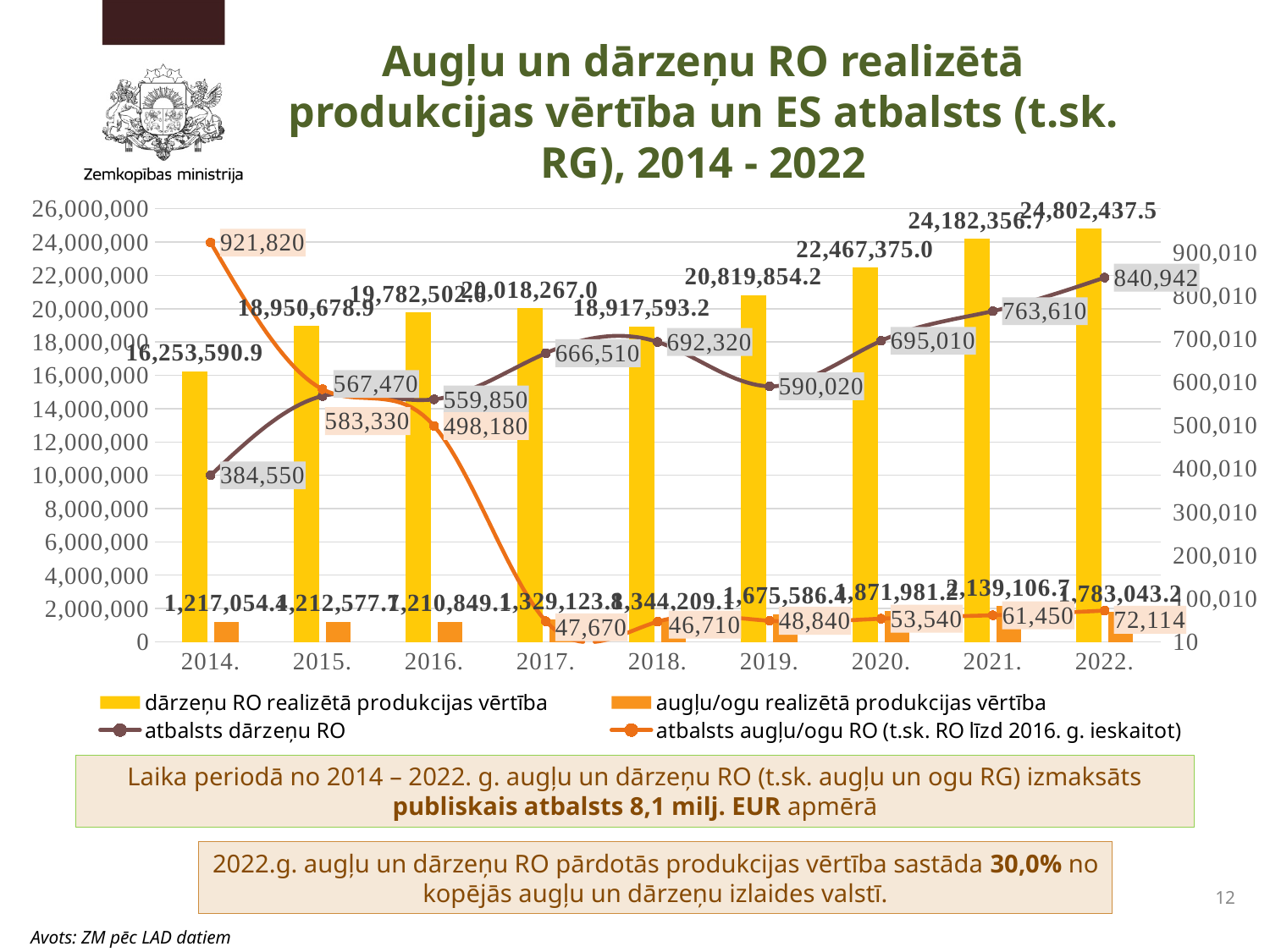
In which year is dārzeņu RO realizētā produkcijas vērtība the highest? 2022 By how much did atbalsts dārzeņu RO increase from 2021 to 2022? 77,332 What is the value of atbalsts dārzeņu RO in 2014? 384,550 What is the value of atbalsts augļu/ogu RO in 2014? 921,820 In 2019, which is larger: atbalsts dārzeņu RO or atbalsts augļu/ogu RO? atbalsts dārzeņu RO What is the difference between dārzeņu RO realizētā produkcijas vērtība in 2022 and in 2021? 620,080.8 Does atbalsts augļu/ogu RO rise or fall from 2014 to 2017? fall What is the value of atbalsts augļu/ogu RO in 2022? 72,114 In which year is atbalsts dārzeņu RO the lowest? 2014 How many series does the chart legend list? 4 What is the value of dārzeņu RO realizētā produkcijas vērtība in 2022? 24,802,437.5 How many years are shown on the x axis of the chart? 9